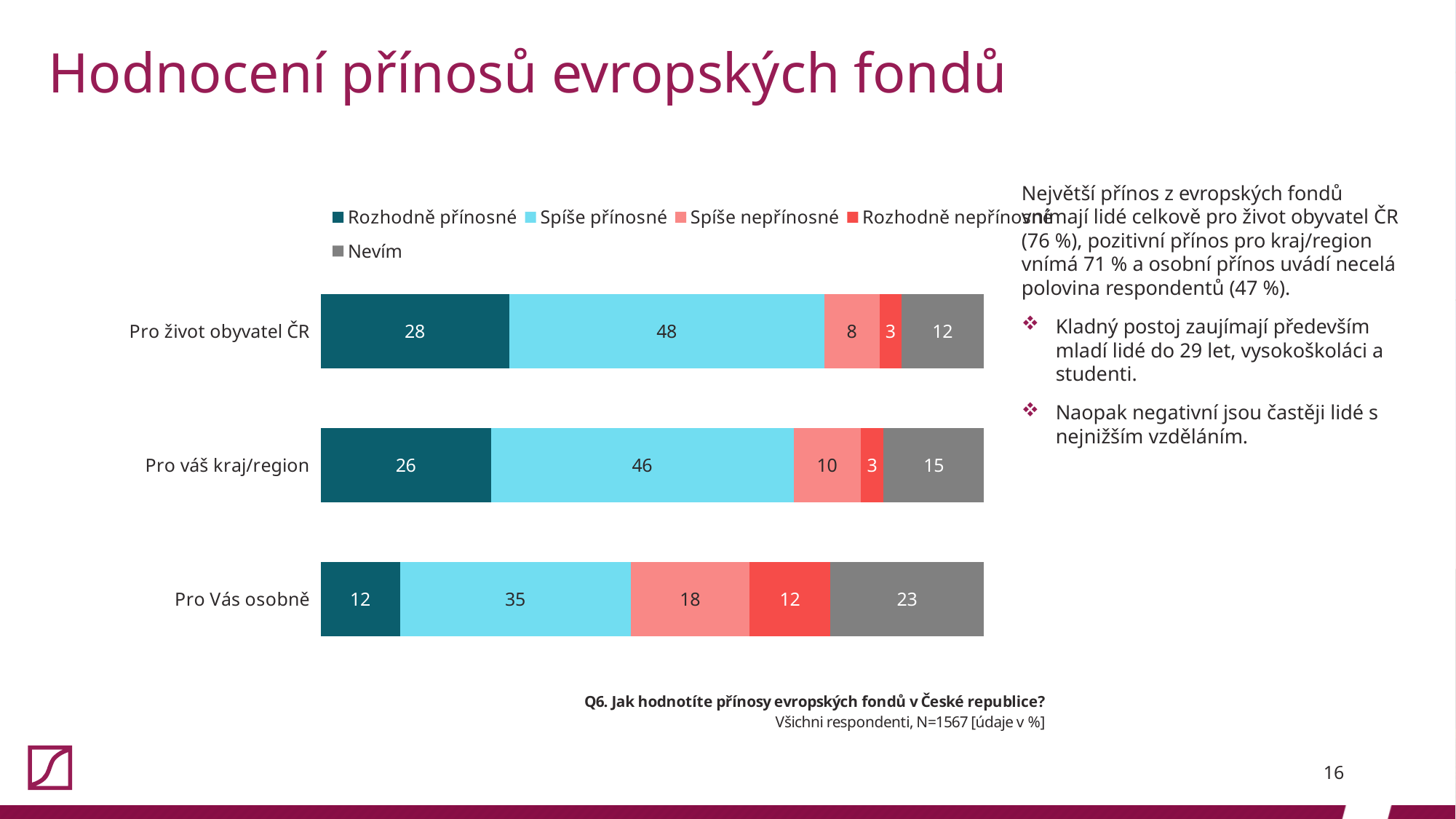
What is the value of "Rozhodně přínosné" for "Pro život obyvatel ČR"? 28 What is the value of "Rozhodně nepřínosné" for "Pro Vás osobně"? 12 What is the total of the stacked bar for "Pro Vás osobně"? 100 Which is larger: the "Nevím" value for "Pro váš kraj/region" or for "Pro život obyvatel ČR"? Pro váš kraj/region What is the value of "Spíše přínosné" for "Pro váš kraj/region"? 46 What kind of chart is shown on the slide? Stacked bar chart What is the value of "Nevím" for "Pro Vás osobně"? 23 How many categories are shown on the chart? 3 Which category has the lowest value for "Rozhodně přínosné"? Pro Vás osobně Which category has the highest value for "Spíše přínosné"? Pro život obyvatel ČR How many series does the legend list? 5 What is the difference between the "Spíše nepřínosné" values for "Pro Vás osobně" and "Pro život obyvatel ČR"? 10